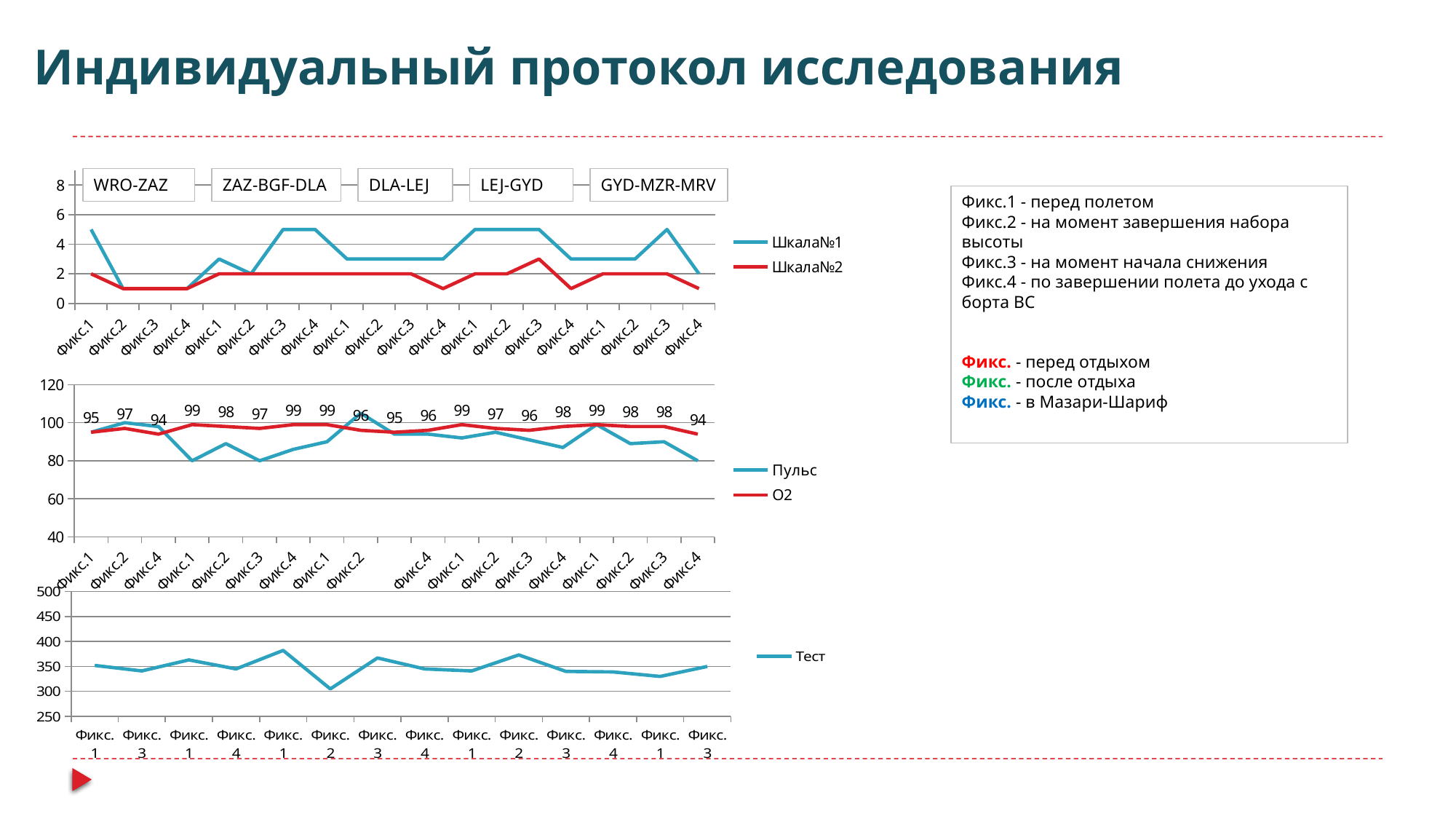
In the middle chart, what is the first data label shown on the O2 series? 95 In the top chart, which series reaches the higher value at the first Фикс.1 point, Шкала№1 or Шкала№2? Шкала№1 In the bottom chart, how many series does the legend list? 1 In the middle chart, what is the highest value labelled on the O2 series? 99 In the top chart, is the value of Шкала№2 at the last Фикс.4 point greater or less than 2? less In the middle chart, what is the lowest value labelled on the O2 series? 94 How many series does the legend of the top chart list? 2 In the top chart, is the value of Шкала№1 at the first Фикс.1 point greater or less than 4? greater In the middle chart, what is the last data label shown on the O2 series? 94 How many charts are on the slide? 3 In the bottom chart (Тест), is the lowest point of the line greater or less than 350? less What kind of chart is the top chart with Шкала№1 and Шкала№2? line chart